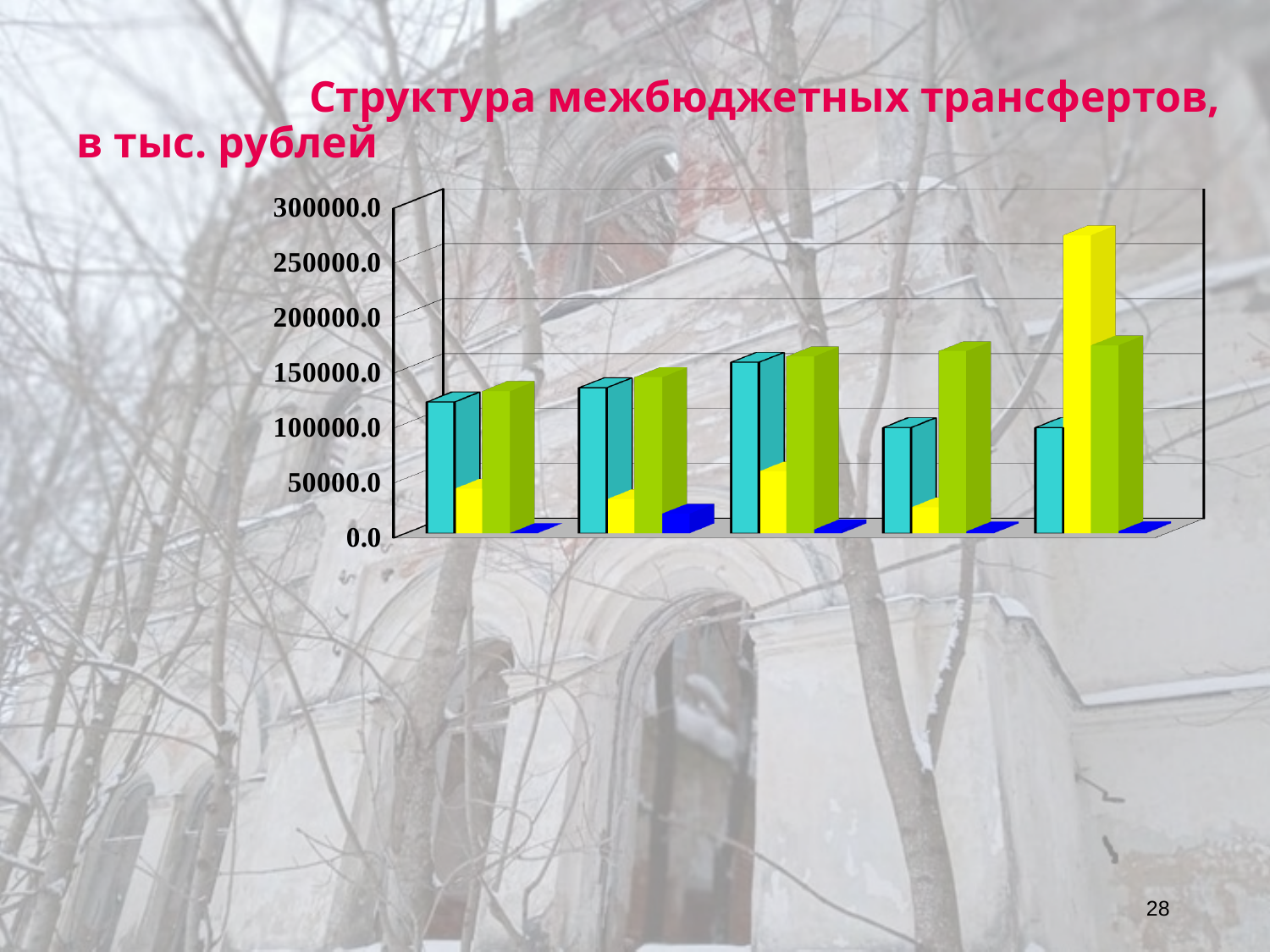
What kind of chart is shown on the slide? bar chart Is the value of the cyan bar in the leftmost group greater or less than 150000.0? less In the rightmost group, which is larger: the yellow bar or the green bar? the yellow bar Is the value of the blue bar in the second group greater or less than 50000.0? less What is the title of the chart? Структура межбюджетных трансфертов, в тыс. рублей Is the value of the cyan bar in the fourth group greater or less than 150000.0? less What is the highest tick value shown on the vertical axis? 300000.0 Which group of bars contains the tallest bar in the chart? the fifth (rightmost) group How many groups of bars are plotted in the chart? 5 Which is larger: the cyan bar in the third group or the cyan bar in the fourth group? the cyan bar in the third group How many bars are there in each group? 4